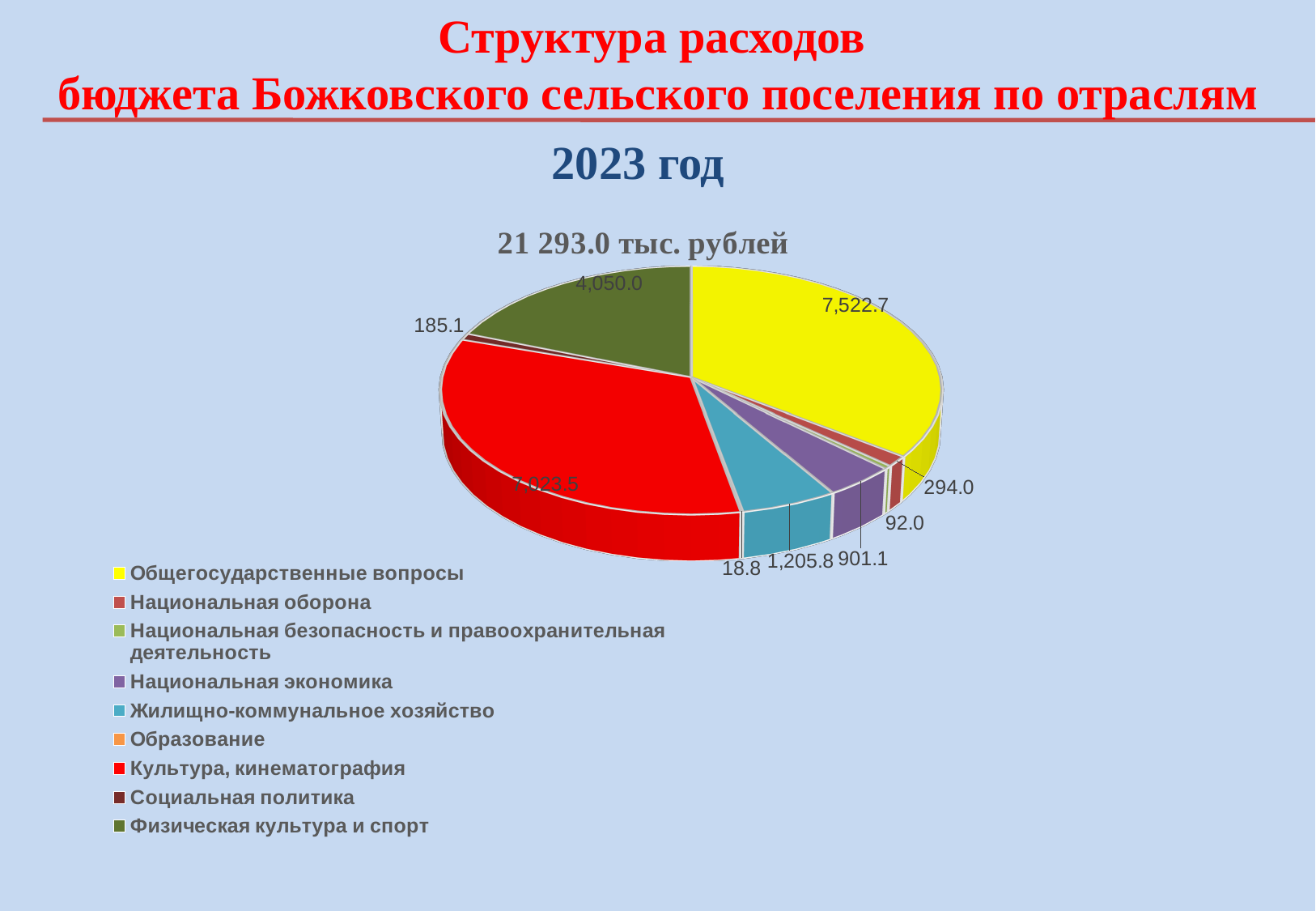
What is the value for Культура, кинематография? 7,023.5 What is the value for Общегосударственные вопросы? 7,522.7 What is the value for Физическая культура и спорт? 4,050.0 What total amount is shown in the chart title? 21 293.0 тыс. рублей Which category has the largest slice? Общегосударственные вопросы Which is larger: the value for Национальная оборона or the value for Социальная политика? Национальная оборона Which category has the smallest slice? Образование How many categories does the legend list? 9 What is the difference between the values for Общегосударственные вопросы and Культура, кинематография? 499.2 What is the value for Национальная экономика? 901.1 What is the value for Жилищно-коммунальное хозяйство? 1,205.8 What type of chart is shown on the slide? Pie chart